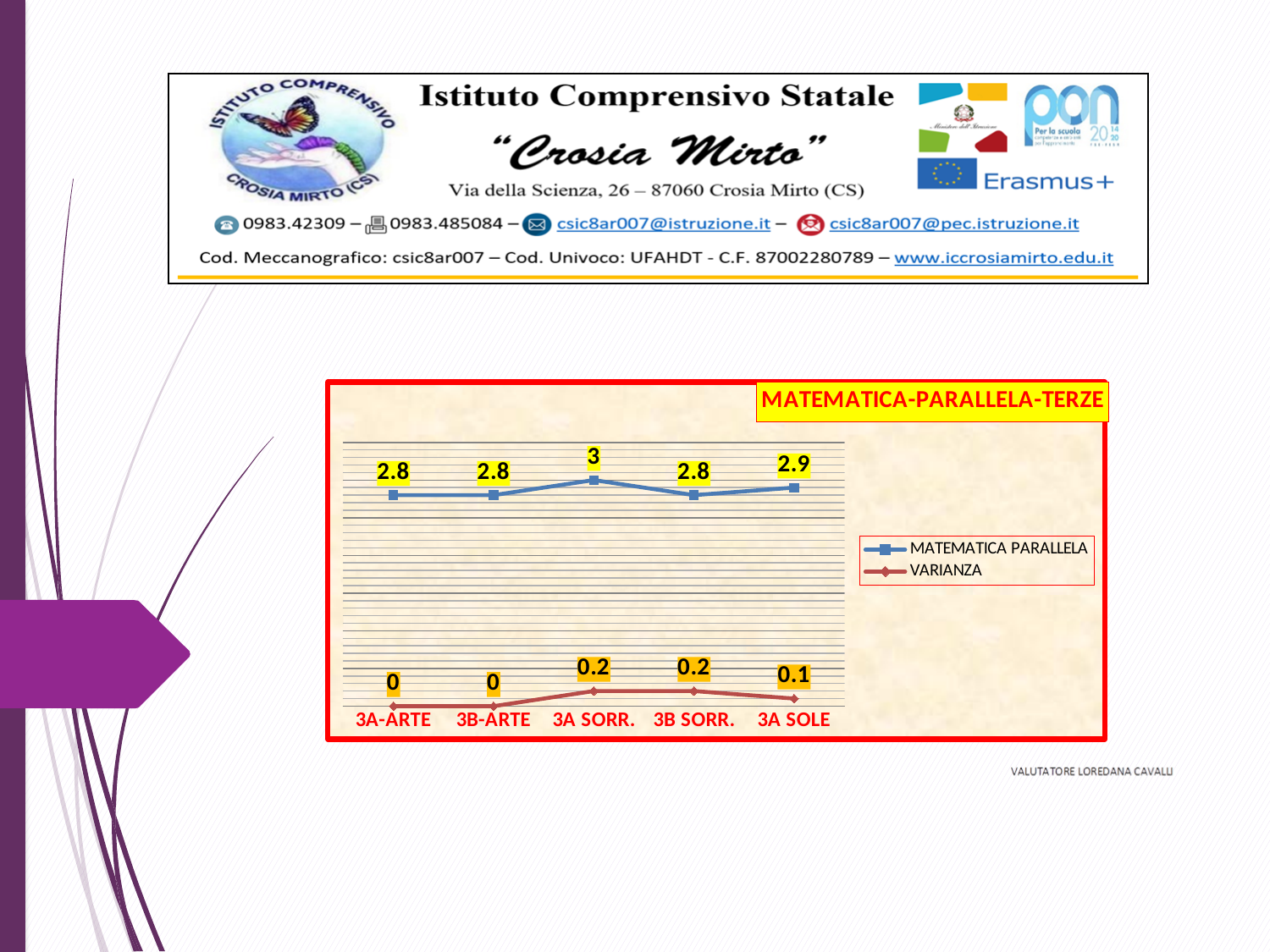
What kind of chart is shown? Line chart What is the MATEMATICA PARALLELA value for 3A SORR.? 3 What is the title of the chart? MATEMATICA-PARALLELA-TERZE What is the VARIANZA value for 3B-ARTE? 0 How many categories are shown on the x axis? 5 Which category has the lowest MATEMATICA PARALLELA value, 3A SOLE or 3B SORR.? 3B SORR. What is the MATEMATICA PARALLELA value for 3A SOLE? 2.9 What is the difference between the MATEMATICA PARALLELA values for 3A SORR. and 3A-ARTE? 0.2 Which category has the highest MATEMATICA PARALLELA value? 3A SORR. How many series does the legend list? 2 Is the VARIANZA value for 3A SORR. larger than the VARIANZA value for 3A SOLE? Yes What is the VARIANZA value for 3A SOLE? 0.1